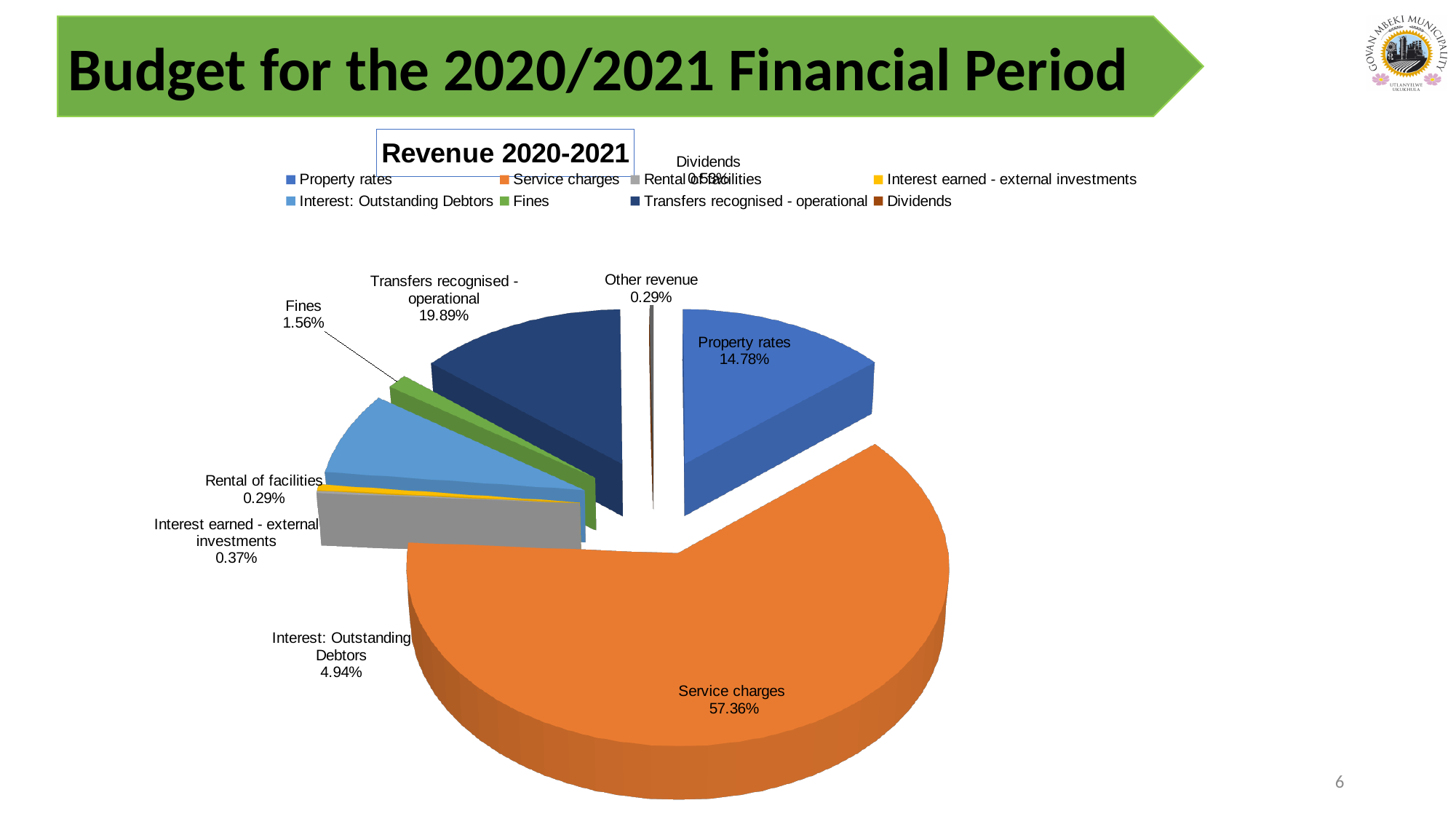
What share of revenue comes from Fines? 1.56% What share of revenue comes from Property rates? 14.78% What share of revenue comes from Interest earned - external investments? 0.37% What share of revenue comes from Service charges? 57.36% What share of revenue comes from Interest: Outstanding Debtors? 4.94% What colour is the Service charges slice? Orange What is the difference between the Service charges share and the Property rates share? 42.58% Which is larger, the share for Transfers recognised - operational or the share for Property rates? Transfers recognised - operational Which revenue source has the largest share of the pie? Service charges What is the title of the chart? Revenue 2020-2021 What kind of chart is shown on the slide? Pie chart What share of revenue comes from Transfers recognised - operational? 19.89%